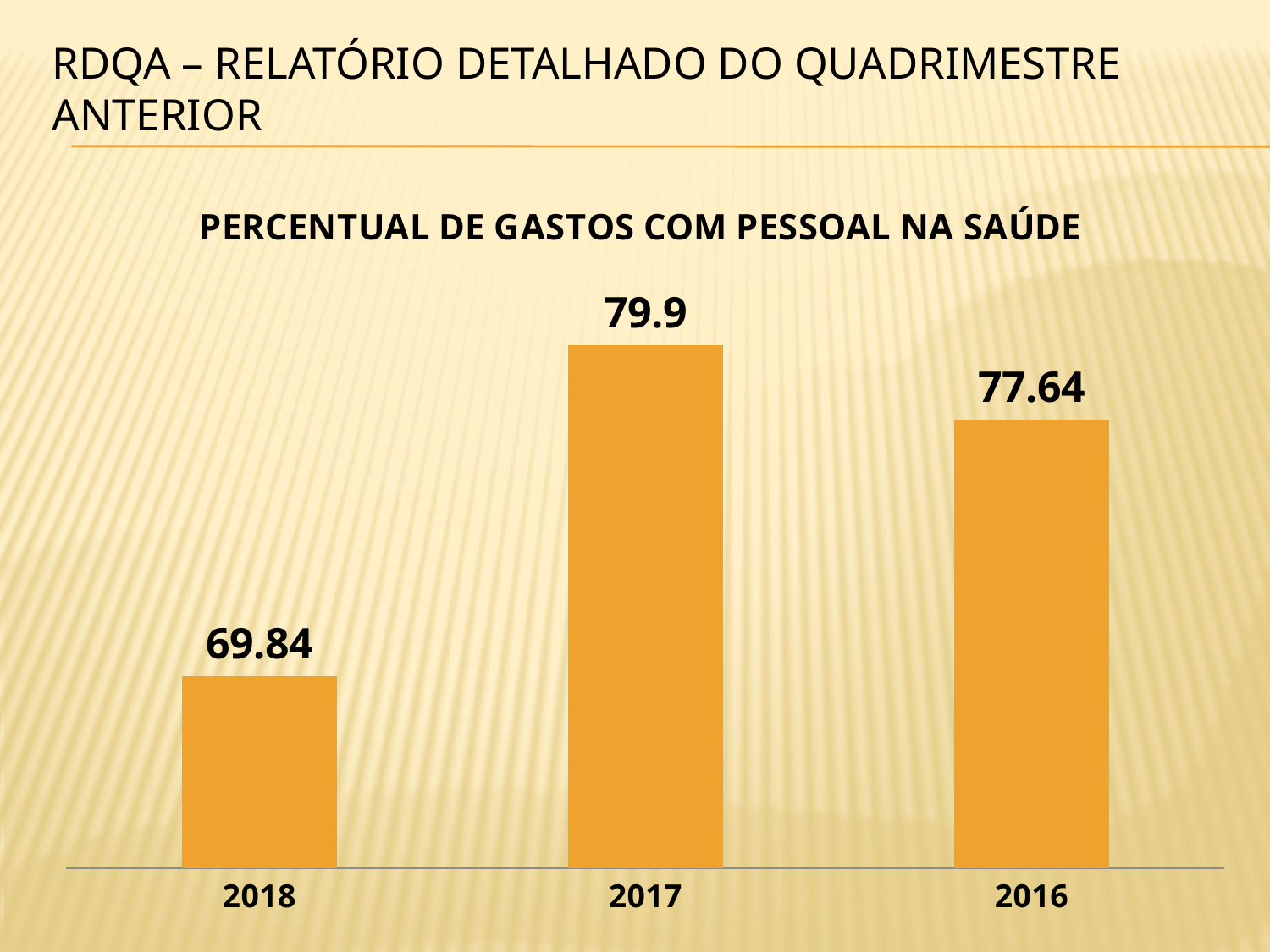
Which year has the lowest value? 2018 How many bars are shown in the chart? 3 What is the value for 2016? 77.64 What is the title of the chart? PERCENTUAL DE GASTOS COM PESSOAL NA SAÚDE What is the difference between the values for 2017 and 2018? 10.06 What kind of chart is shown on the slide? Bar chart What is the difference between the values for 2017 and 2016? 2.26 Which year has the highest value? 2017 What is the value for 2017? 79.9 What colour are the bars in the chart? Orange What is the value for 2018? 69.84 Which is larger, the value for 2016 or the value for 2018? 2016